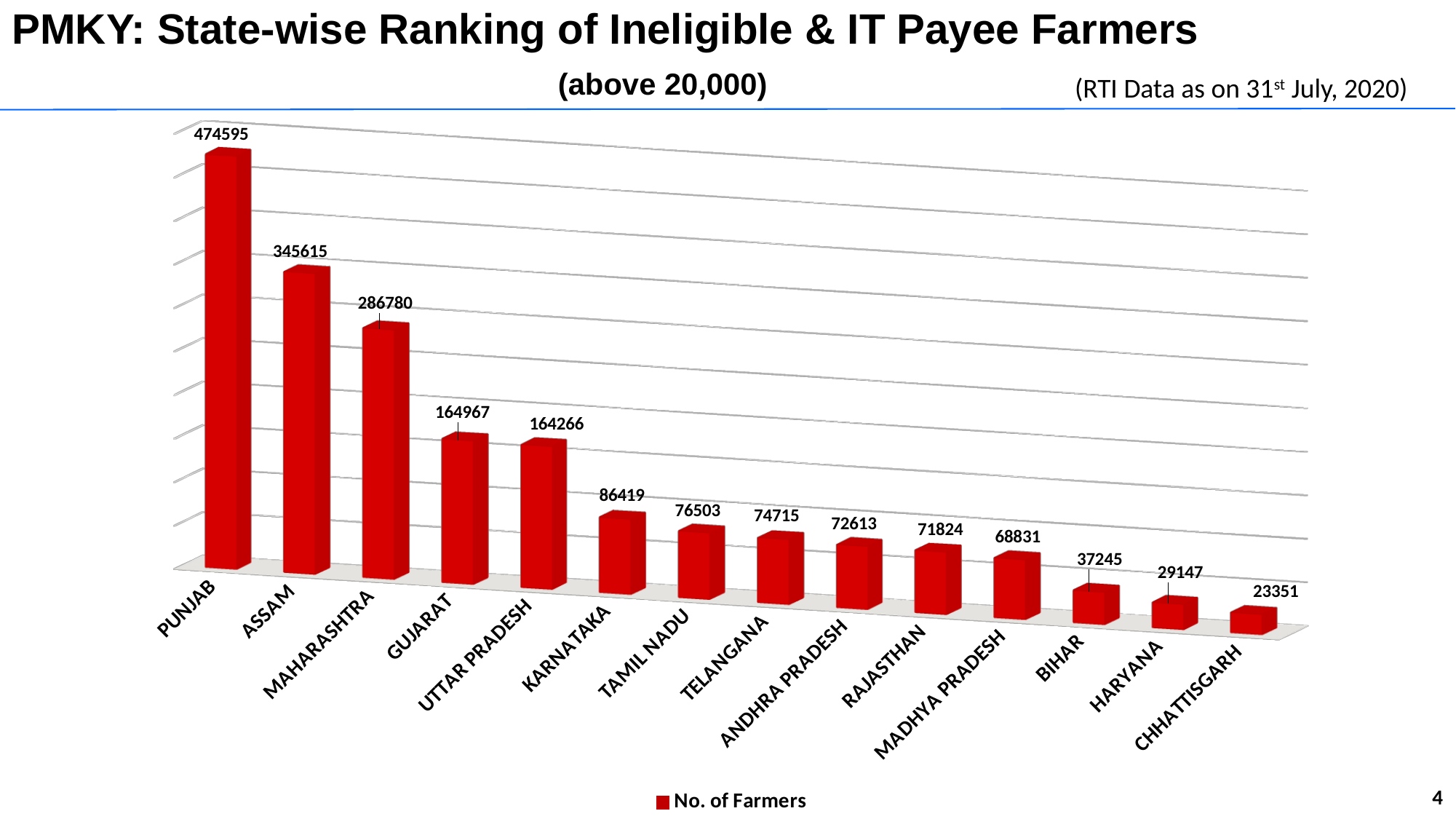
How many series does the legend list? 1 Which has a larger value, Maharashtra or Gujarat? Maharashtra How many states are shown in the chart? 14 Which state has the lowest number of farmers? Chhattisgarh What is the difference between the values for Bihar and Haryana? 8098 What is the number of farmers for Punjab? 474595 What is the legend entry for the series in the chart? No. of Farmers What is the number of farmers for Karnataka? 86419 What is the difference between the values for Punjab and Assam? 128980 What is the number of farmers for Bihar? 37245 Which state has the highest number of farmers? Punjab What kind of chart is shown on the slide? Bar chart